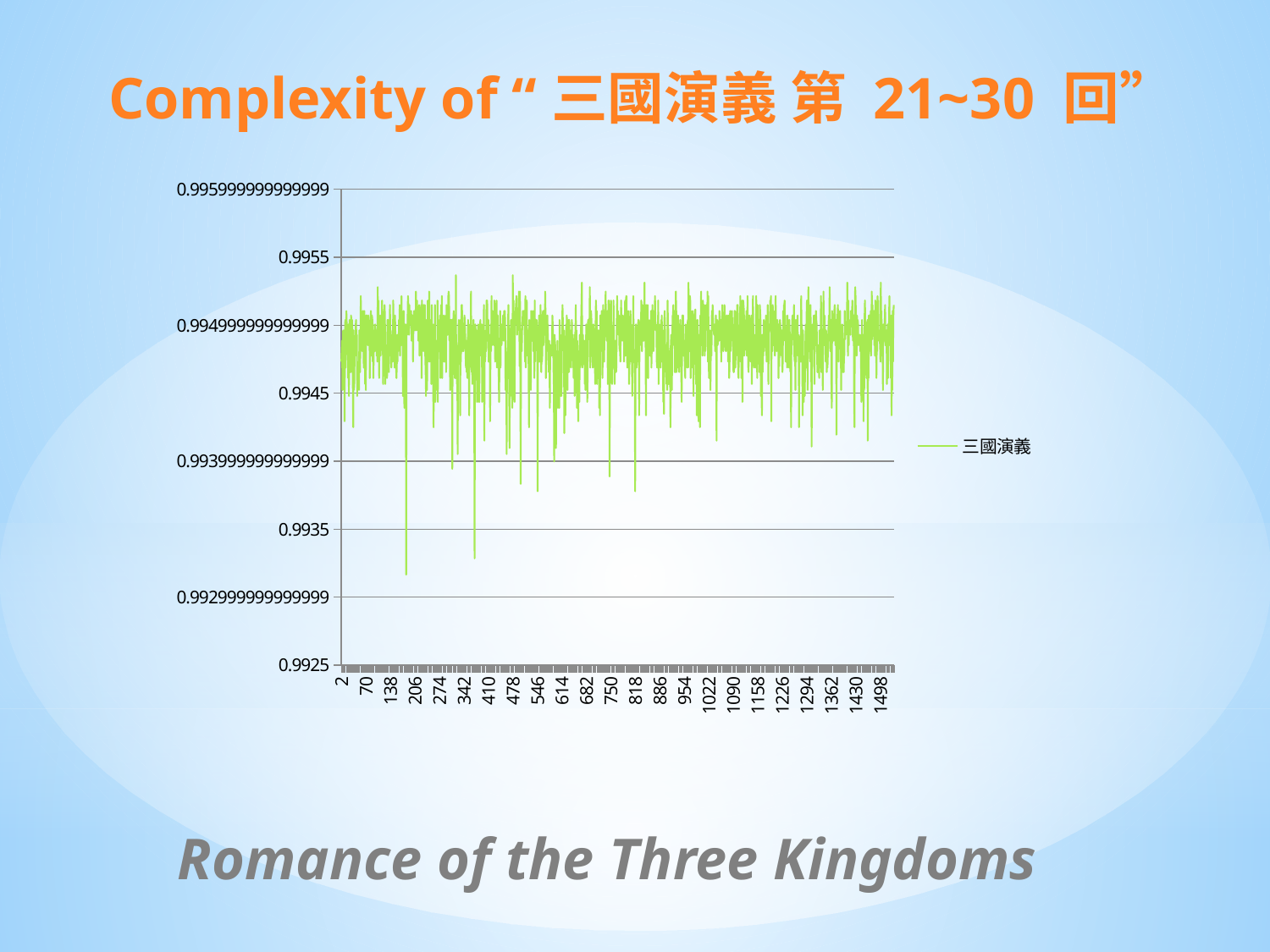
Is the highest value plotted on the chart greater or less than 0.9955? less Is the value at the first x-axis point (2) greater or less than 0.9935? greater What is the title of the slide containing the chart? Complexity of “ 三國演義 第 21~30 回” Is the lowest value plotted on the chart greater or less than 0.9935? less Do the plotted values show a clear overall rise or fall along the x axis, or no clear trend? no clear trend How many series does the legend list? 1 What kind of chart is shown on the slide? line chart What is the name of the series shown in the legend? 三國演義